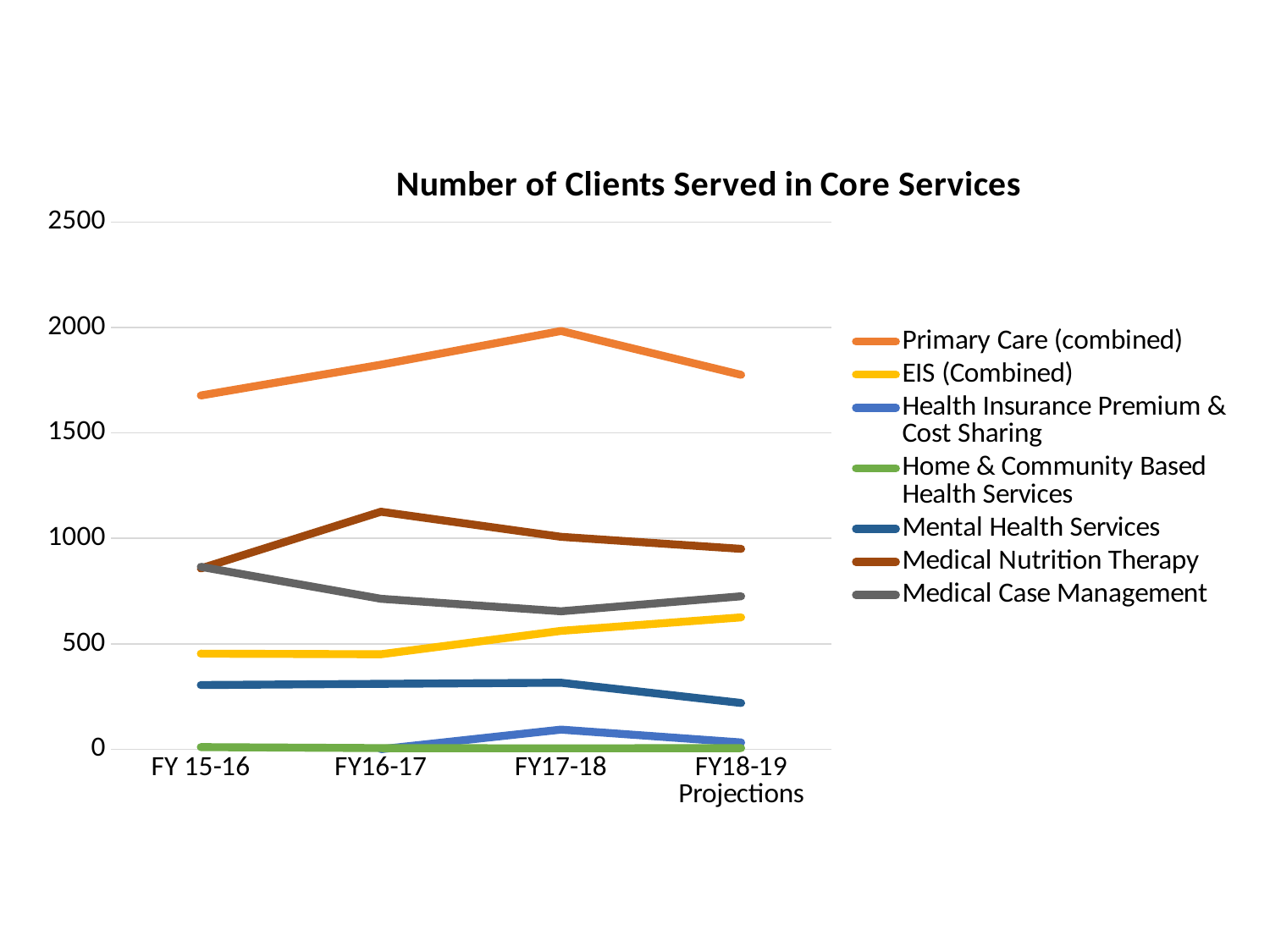
Is the value for Medical Nutrition Therapy in FY16-17 greater or less than 1000? greater What kind of chart is shown on the slide? line chart What is the title of the chart? Number of Clients Served in Core Services How many fiscal-year categories are shown on the x axis? 4 Does the Medical Case Management line rise or fall from FY 15-16 to FY17-18? fall How many series does the legend list? 7 In FY16-17, which is larger: Medical Nutrition Therapy or Medical Case Management? Medical Nutrition Therapy Which series has the highest value in FY17-18? Primary Care (combined) Is the value for Medical Case Management in FY17-18 greater or less than 1000? less Is the value for EIS (Combined) in FY18-19 Projections greater or less than 500? greater Which series has the lowest value in FY17-18? Home & Community Based Health Services